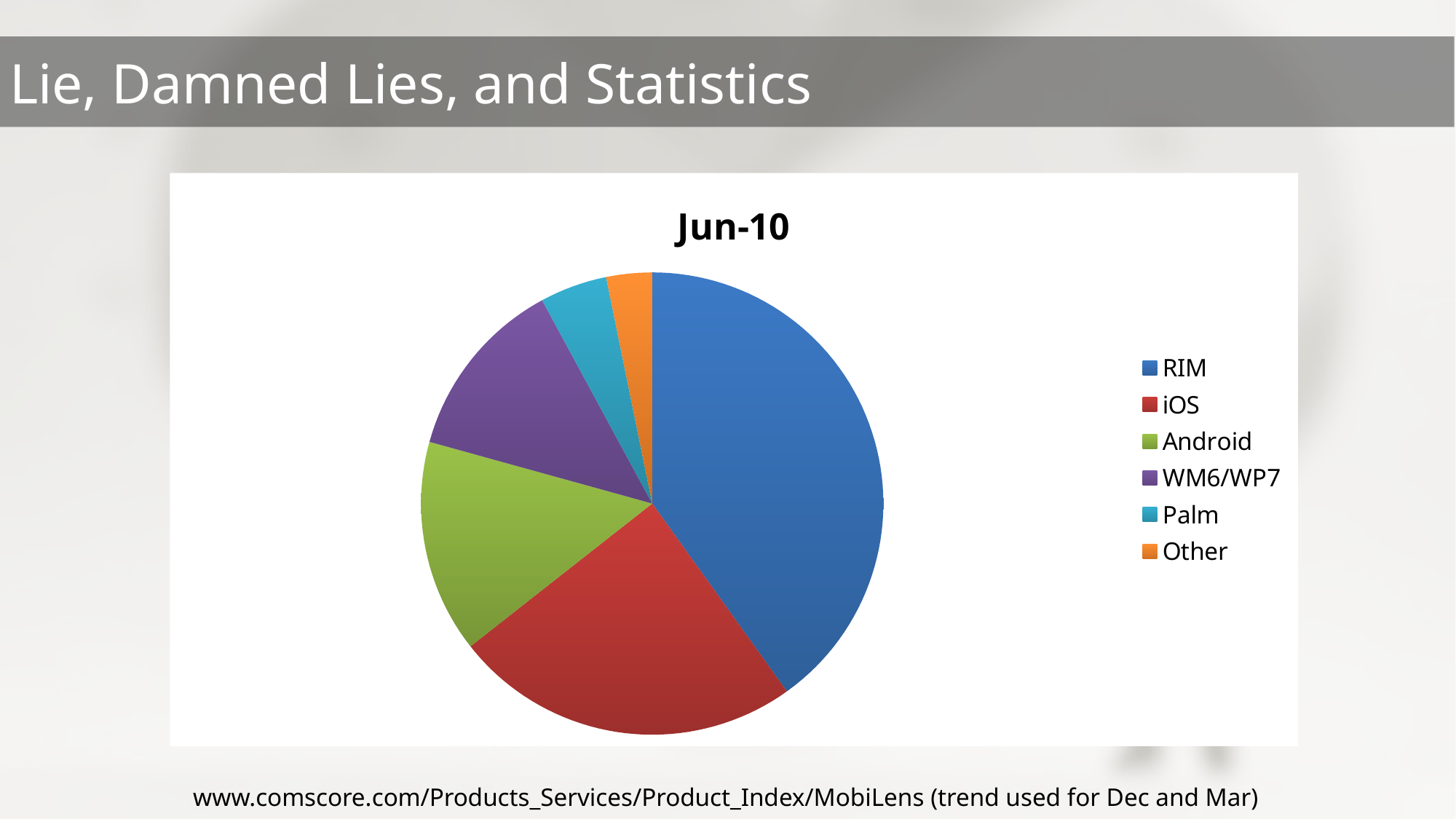
Which category has the smallest slice of the pie? Other Which slice is larger, iOS or Android? iOS What kind of chart is shown on the slide? pie chart How many slices does the pie chart have? 6 Which slice is larger, RIM or iOS? RIM Which slice is larger, Android or Other? Android What is the title of the chart? Jun-10 Which category has the largest slice of the pie? RIM Which category is shown in blue in the legend? RIM How many entries does the legend list? 6